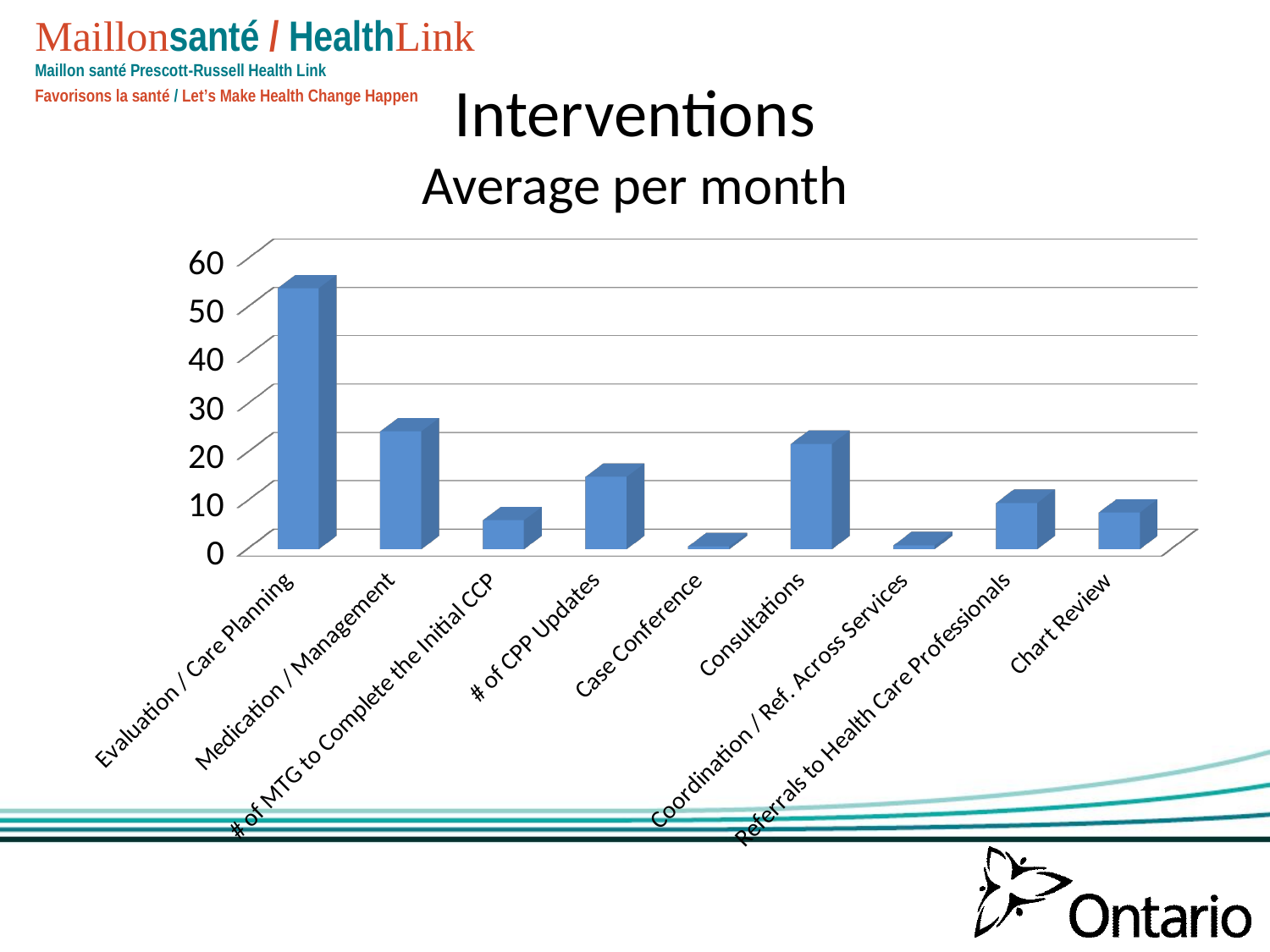
Is the value for # of MTG to Complete the Initial CCP greater or less than 10? less Which intervention category has the highest average per month? Evaluation / Care Planning Is the value for Consultations greater or less than 30? less Is the value for Case Conference greater or less than 10? less What kind of chart is shown on the slide? Bar chart Which is larger, the value for Chart Review or the value for Coordination / Ref. Across Services? Chart Review Which is larger, the value for Medication / Management or the value for # of CPP Updates? Medication / Management What is the title of the chart? Interventions Average per month How many intervention categories are plotted on the chart? 9